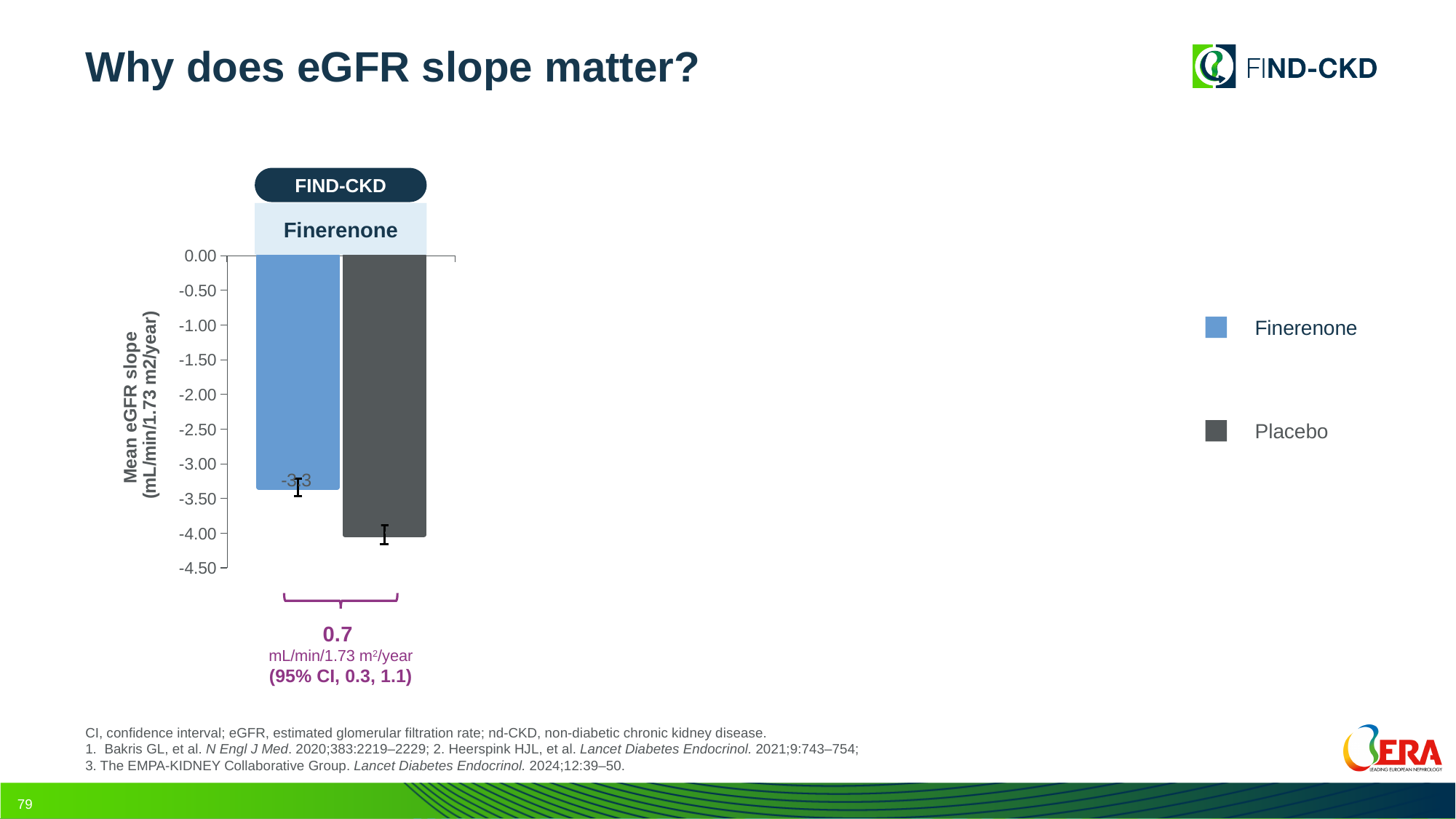
Is the mean eGFR slope for Placebo greater or less than -3.50? less What is the 95% confidence interval given for the difference in eGFR slope? 0.3, 1.1 Which study name is shown in the label above the bars? FIND-CKD Is the mean eGFR slope for Finerenone greater or less than -4.00? greater Which bar has the higher (less negative) mean eGFR slope, Finerenone or Placebo? Finerenone What difference in eGFR slope between Finerenone and Placebo is annotated below the bars? 0.7 mL/min/1.73 m²/year How many bars are plotted in the chart? 2 What is the mean eGFR slope value labelled on the Finerenone bar? -3.3 What colour represents Placebo in the legend? dark grey What type of chart is shown on the slide? bar chart Which group has the lowest (most negative) mean eGFR slope? Placebo How many series does the legend list? 2